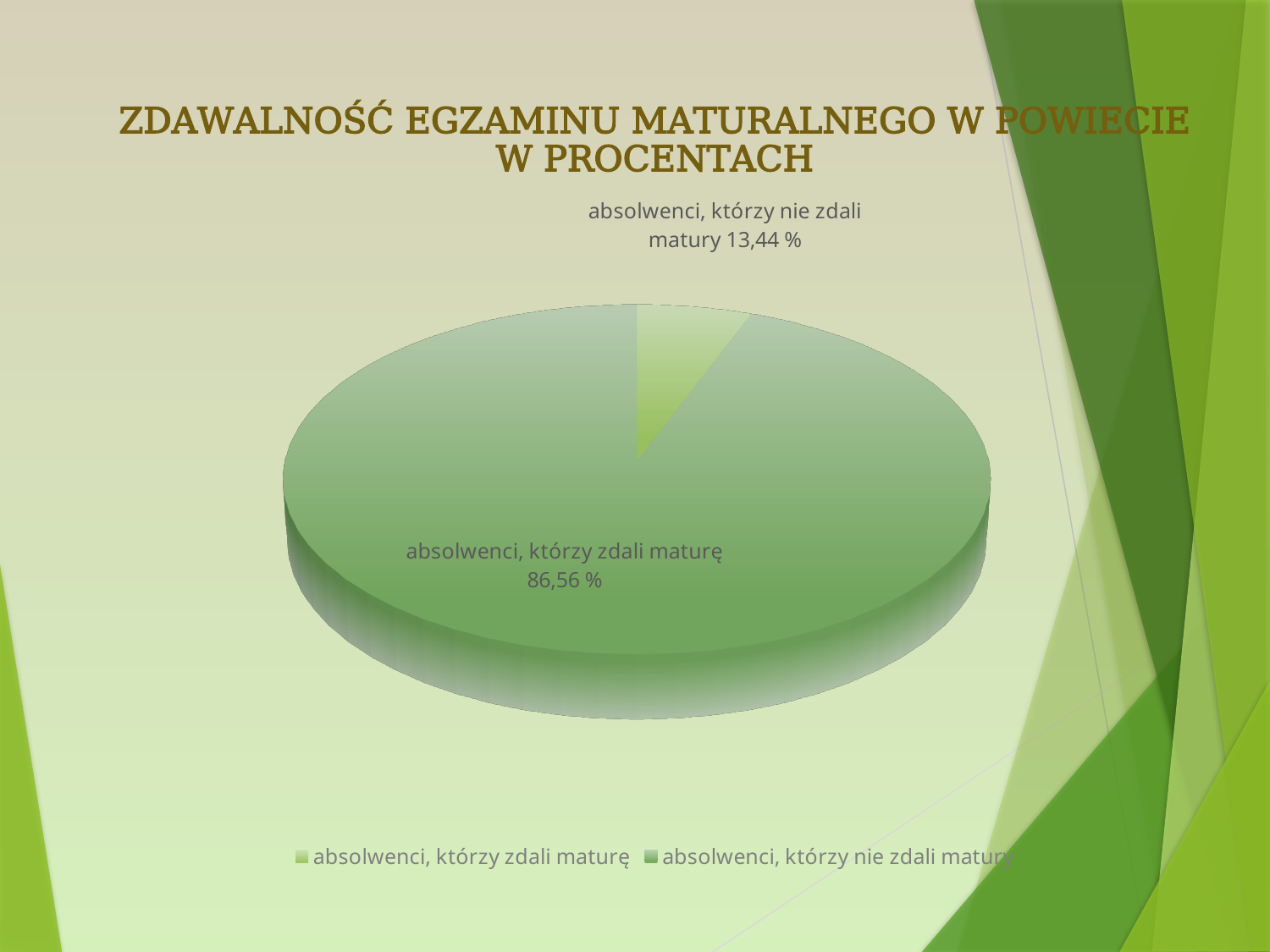
What kind of chart is shown on the slide? pie chart What is the value shown for "absolwenci, którzy zdali maturę"? 86,56 % Which slice of the pie is the largest? absolwenci, którzy zdali maturę What is the value shown for "absolwenci, którzy nie zdali matury"? 13,44 % What is the difference between the share of graduates who passed and those who did not pass? 73,12 % Which slice of the pie is the smallest? absolwenci, którzy nie zdali matury What share of the pie does "absolwenci, którzy nie zdali matury" represent? 13,44 % What is the first entry listed in the legend? absolwenci, którzy zdali maturę How many slices does the pie chart have? 2 How many entries does the legend list? 2 Which is larger: the share of "absolwenci, którzy zdali maturę" or "absolwenci, którzy nie zdali matury"? absolwenci, którzy zdali maturę What is the title of the chart on the slide? ZDAWALNOŚĆ EGZAMINU MATURALNEGO W POWIECIE W PROCENTACH